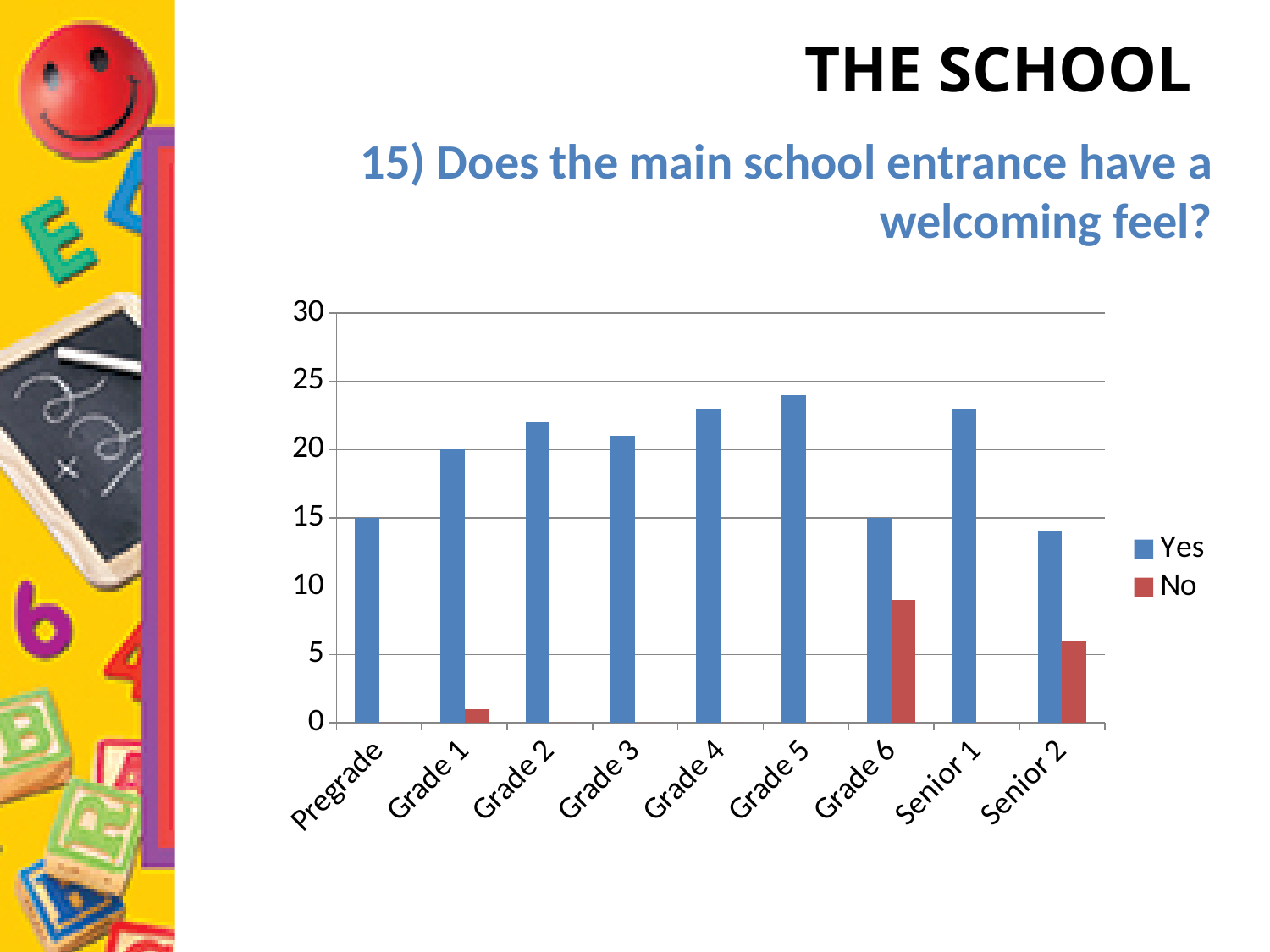
What is the Yes value for Grade 1? 20 Is the No value for Grade 1 greater or less than 5? less Which is larger, the No value for Grade 6 or the No value for Senior 2? Grade 6 What kind of chart is shown on the slide? bar chart What colour are the No bars in the chart? red Which category has the highest No value? Grade 6 Is the Yes value for Grade 5 greater or less than 20? greater How many grade categories are shown on the x axis? 9 Which is larger, the Yes value for Grade 5 or the Yes value for Pregrade? Grade 5 What is the Yes value for Pregrade? 15 How many series does the legend list? 2 Is the No value for Grade 6 greater or less than 10? less